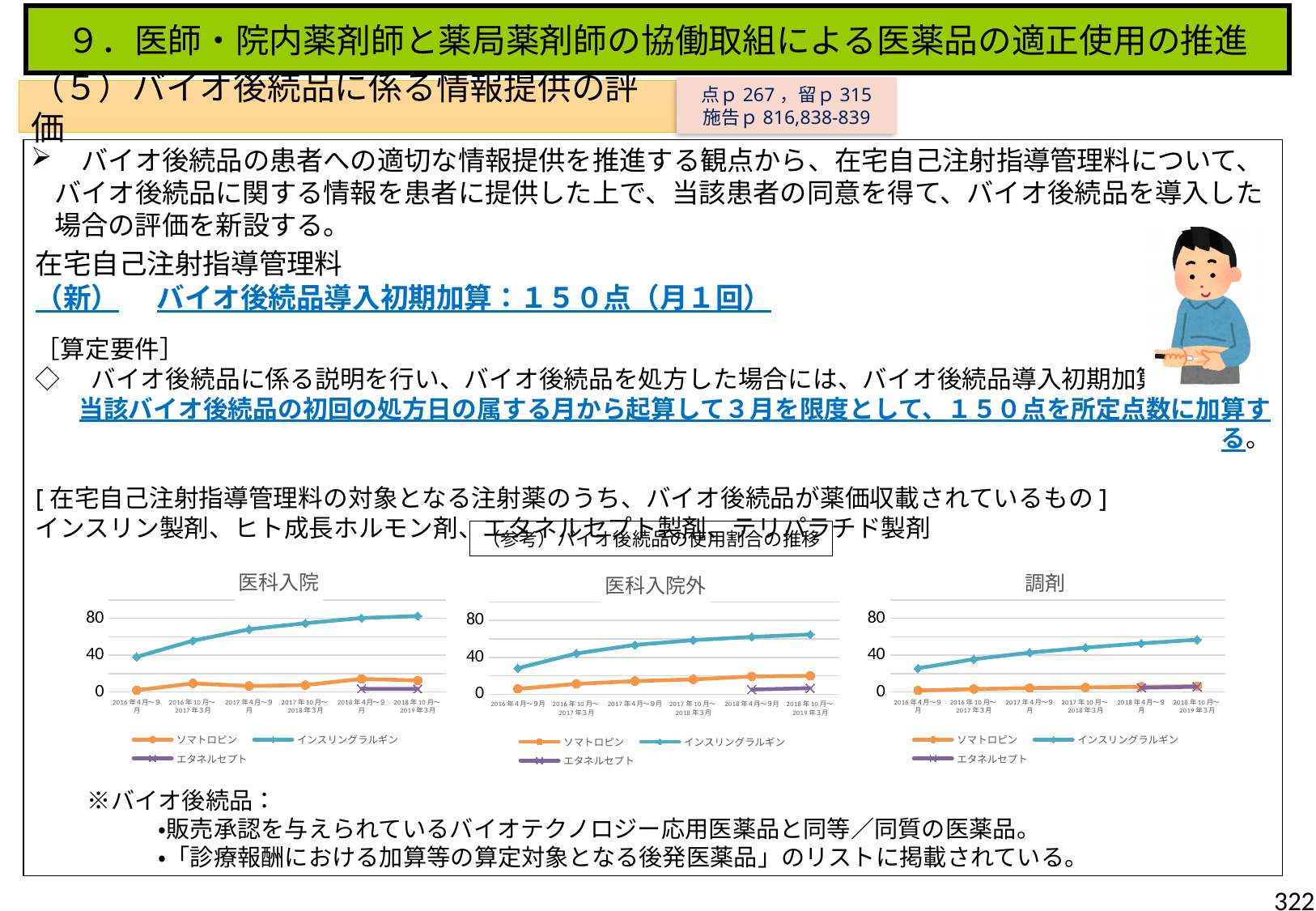
How many series does the legend of the 医科入院外 chart list? 3 What is the title of the chart on the right of the slide? 調剤 In the 調剤 chart, which series has the highest value in 2018年10月～2019年3月? インスリングラルギン In the 医科入院外 chart, which is larger in 2018年10月～2019年3月: ソマトロピン or エタネルセプト? ソマトロピン In the 調剤 chart, is the value for インスリングラルギン in 2018年10月～2019年3月 greater or less than 40? greater What kind of chart is the 医科入院 chart? line chart How many time periods are shown on the x axis of the 調剤 chart? 6 Which series is shown in orange in the 調剤 chart? ソマトロピン In the 医科入院 chart, does the インスリングラルギン line rise or fall from 2016年4月～9月 to 2018年10月～2019年3月? rise In the 医科入院外 chart, is the value for インスリングラルギン in 2016年4月～9月 greater or less than 40? less In the 医科入院 chart, is the value for ソマトロピン in 2018年10月～2019年3月 greater or less than 40? less